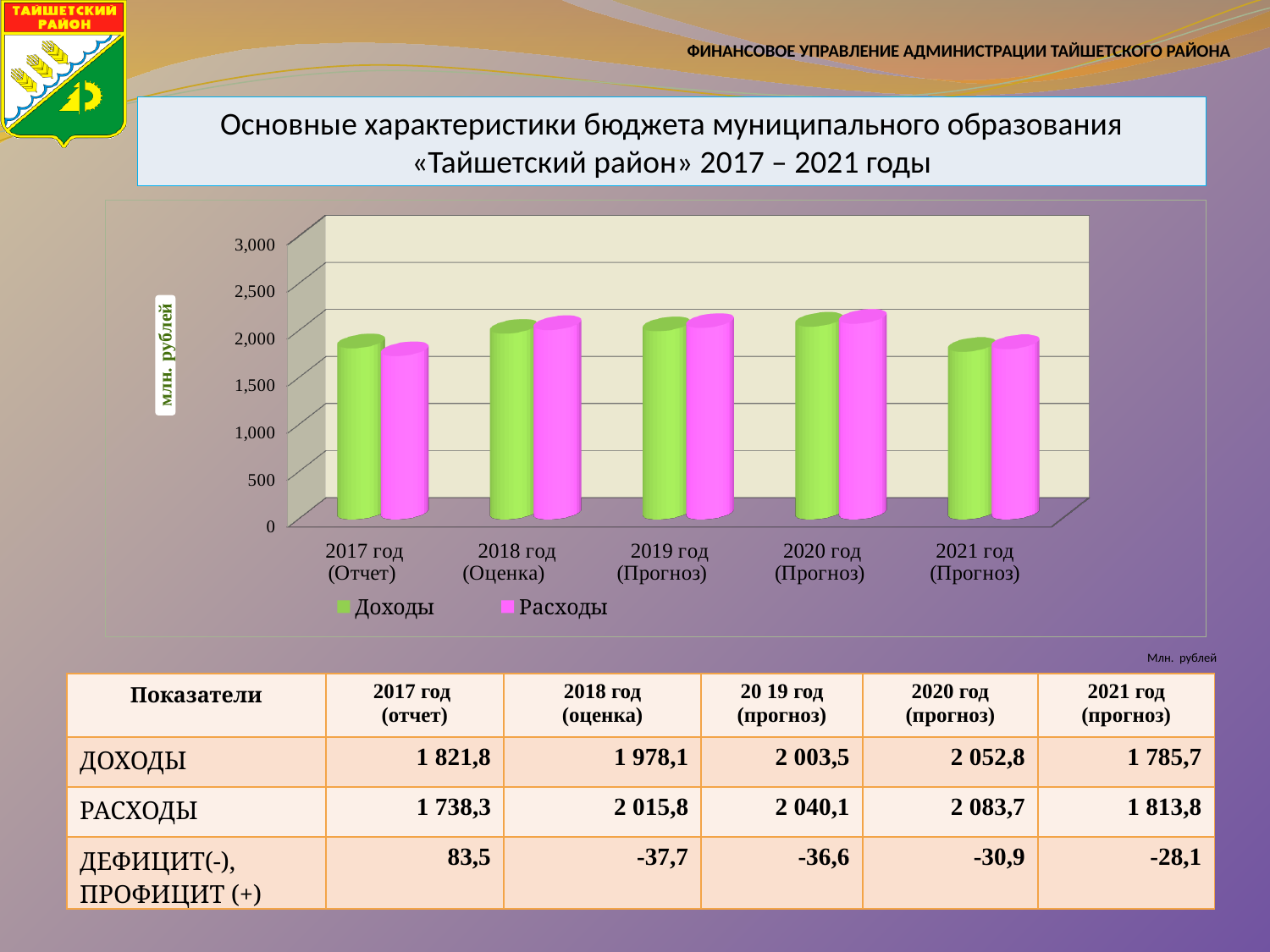
What is the value of Расходы for 2020 год (Прогноз)? 2 083,7 What are the two series named in the chart legend? Доходы and Расходы In which year are Доходы the highest? 2020 год (Прогноз) What is the value of Доходы for 2017 год (Отчет)? 1 821,8 What kind of chart is shown on the slide? bar chart What unit is shown on the vertical axis of the chart? млн. рублей How many year categories are shown on the x axis of the chart? 5 Is the value of Расходы for 2020 год (Прогноз) greater or less than 2,000? greater How many series does the chart legend list? 2 In which year are Расходы the lowest? 2017 год (Отчет) Which is larger in 2019 год (Прогноз), Доходы or Расходы? Расходы Is the value of Расходы for 2017 год (Отчет) greater or less than 2,000? less